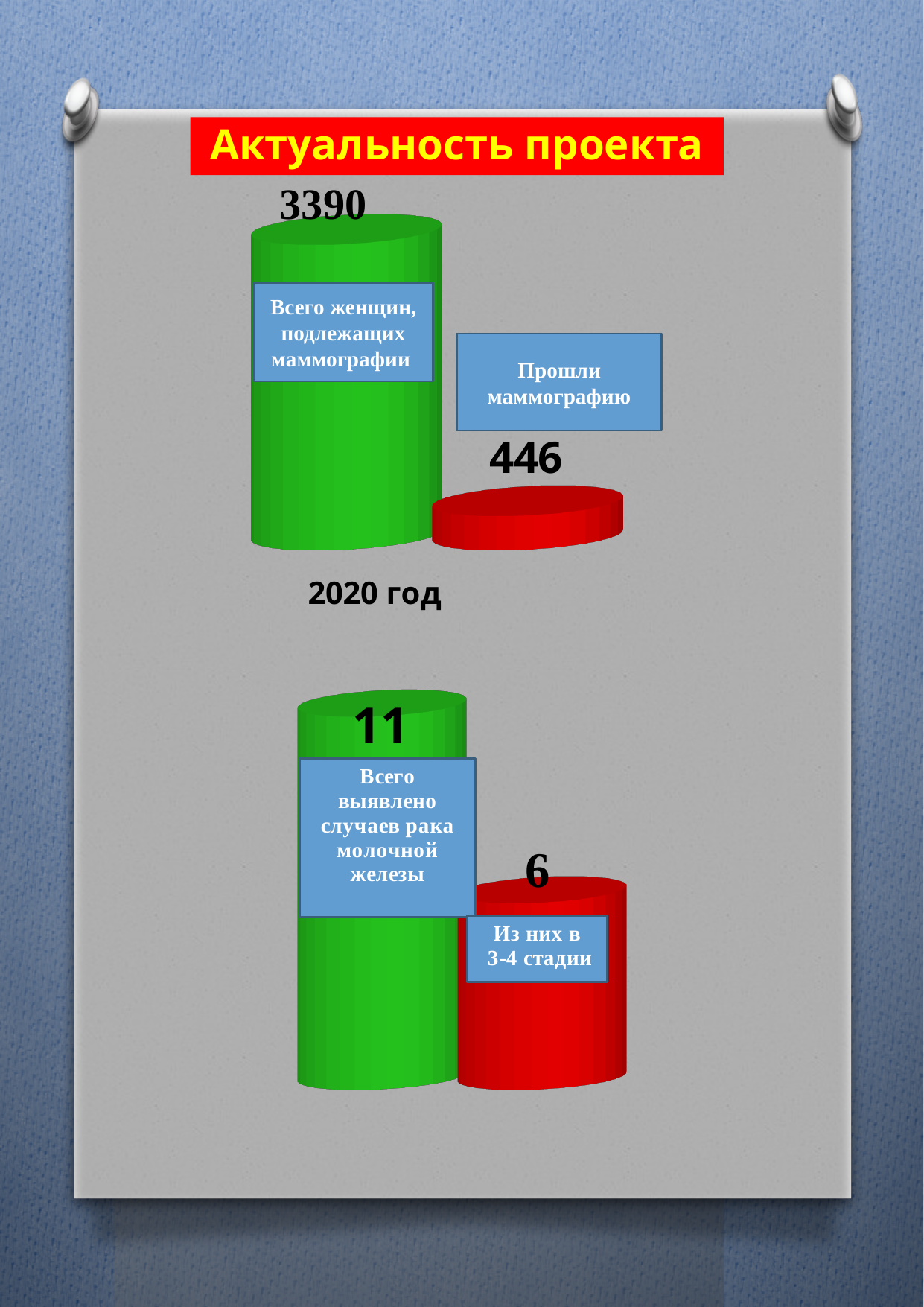
What kind of chart is the top chart? Bar chart In the top chart, which category has the lower value? Прошли маммографию In the bottom chart, which category has the higher value? Всего выявлено случаев рака молочной железы In the top chart, what is the value for 'Прошли маммографию'? 446 How many bars does the bottom chart have? 2 In the bottom chart, what is the value for 'Всего выявлено случаев рака молочной железы'? 11 In the top chart, what is the difference between 'Всего женщин, подлежащих маммографии' and 'Прошли маммографию'? 2944 In the top chart, what is the value for 'Всего женщин, подлежащих маммографии'? 3390 In the bottom chart, what colour is the bar for 'Из них в 3-4 стадии'? Red In the bottom chart, what is the value for 'Из них в 3-4 стадии'? 6 In the bottom chart, what is the difference between 'Всего выявлено случаев рака молочной железы' and 'Из них в 3-4 стадии'? 5 In the top chart, which year is shown below the bars? 2020 год